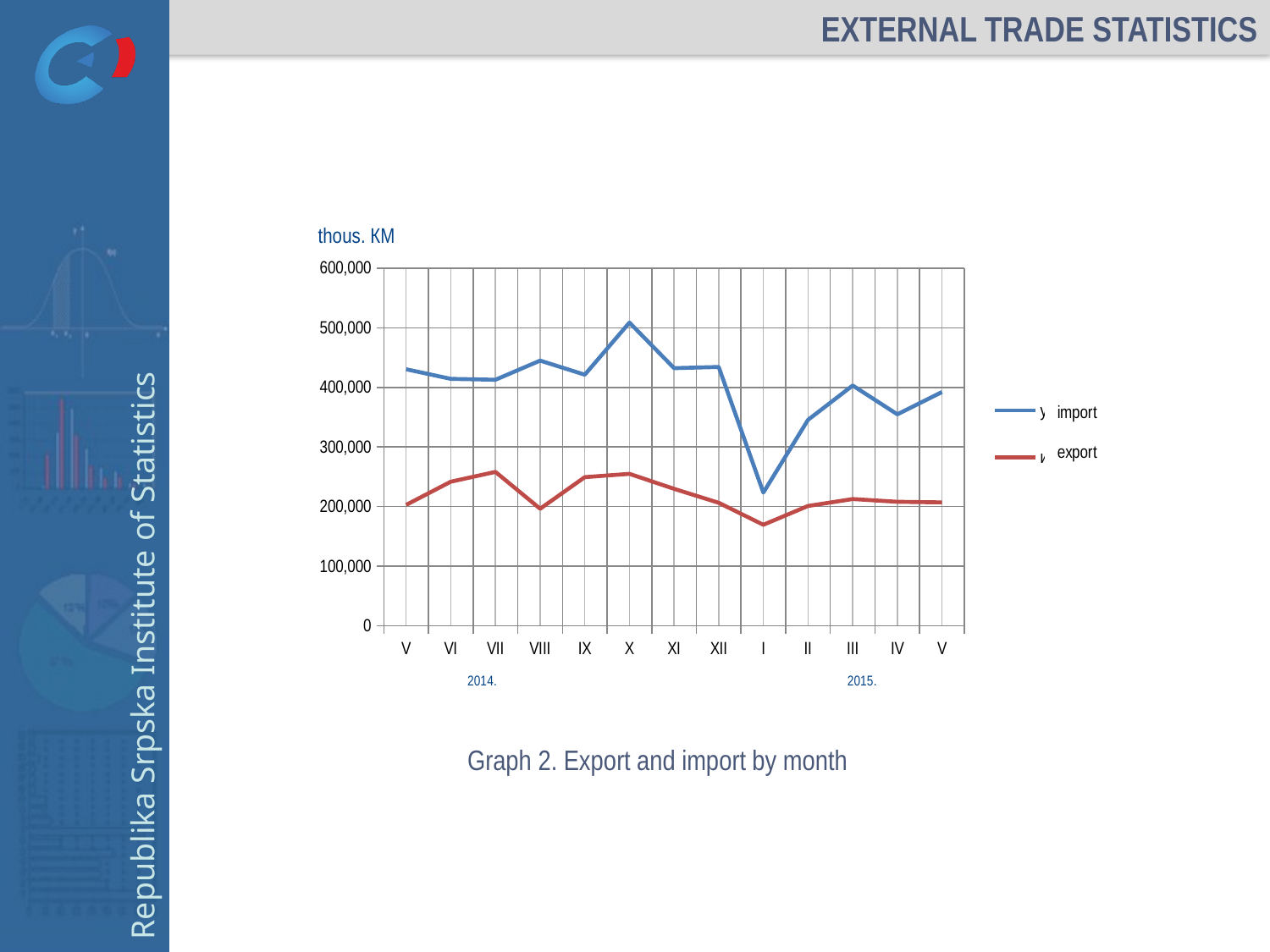
How many months are plotted along the x axis? 13 What kind of chart is shown on the slide? line chart In which month does the export line reach its lowest value? I (2015) How many series does the legend list? 2 In which month does the import line reach its lowest value? I (2015) Is the export value for month VII of 2014 greater or less than 200,000? greater In which month does the import line reach its highest value? X (2014) Does the import line rise or fall from month XII of 2014 to month I of 2015? fall Which is larger in month X of 2014, import or export? import What unit is shown above the y axis of the chart? thous. KM Is the import value for month V of 2014 greater or less than 400,000? greater Is the import value for month I of 2015 greater or less than 300,000? less